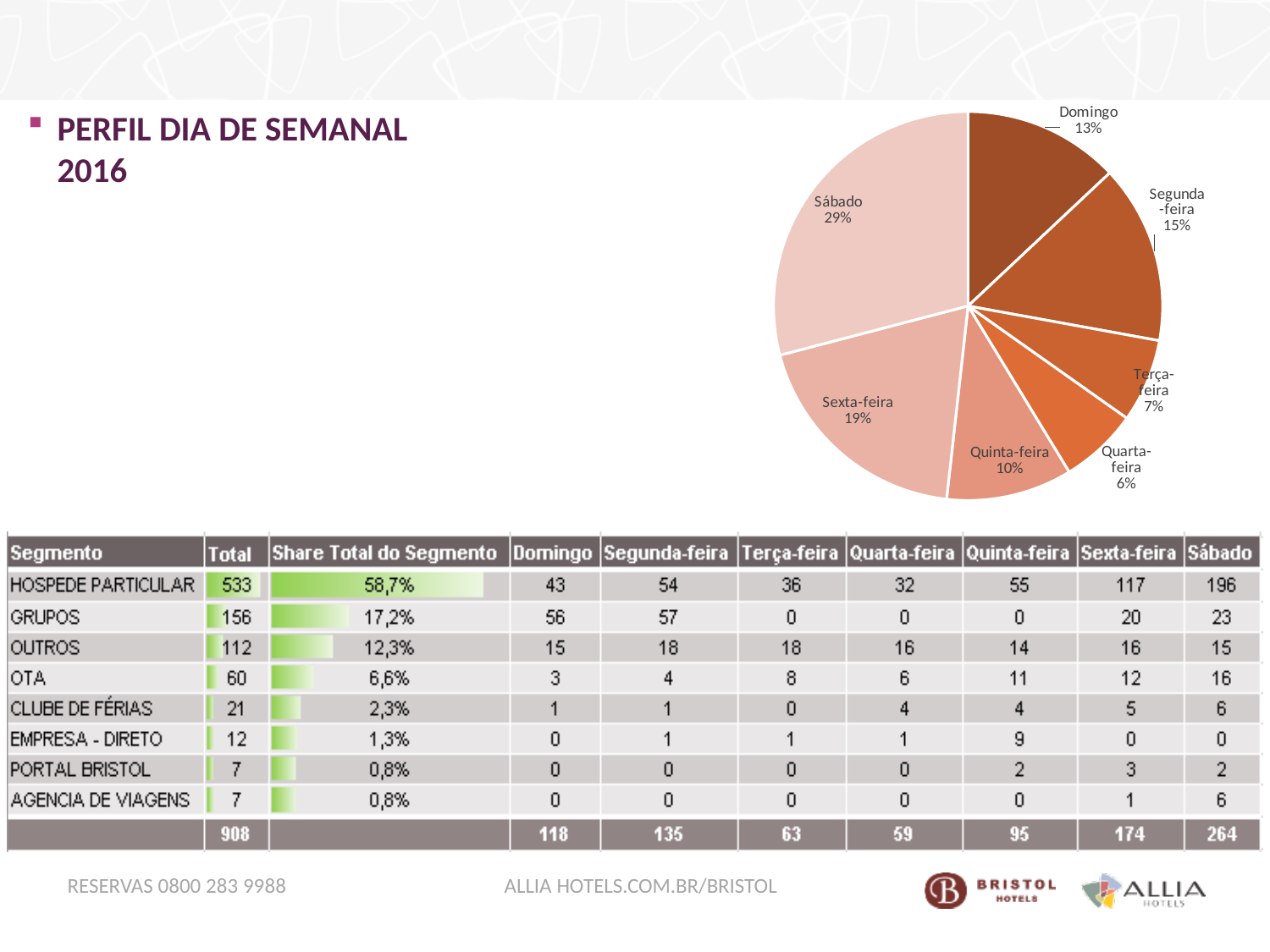
Which has a larger share in the pie chart, Segunda-feira or Terça-feira? Segunda-feira What is the title of the slide containing the pie chart? PERFIL DIA DE SEMANAL 2016 What is the difference in percentage points between Sábado and Sexta-feira in the pie chart? 10 What is the percentage shown for Sexta-feira in the pie chart? 19% What is the percentage shown for Quinta-feira in the pie chart? 10% What is the difference in percentage points between Segunda-feira and Domingo in the pie chart? 2 Which day has the largest slice in the pie chart? Sábado Which day has the smallest slice in the pie chart? Quarta-feira What kind of chart is shown on the slide? pie chart How many slices does the pie chart have? 7 What is the percentage shown for Domingo in the pie chart? 13% What share of the pie does Sábado represent? 29%